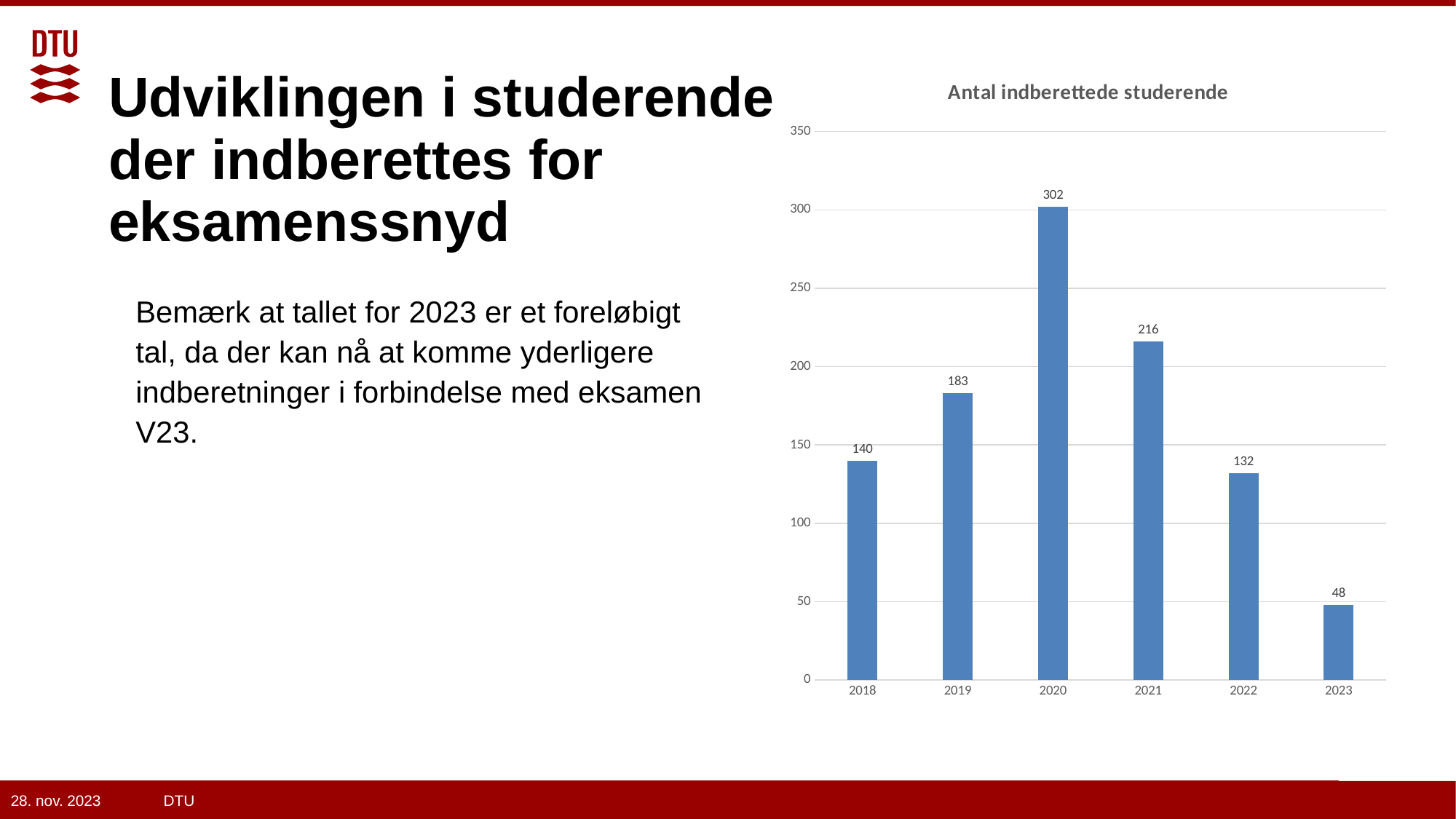
What is the title of the chart? Antal indberettede studerende What kind of chart is shown on the slide? Bar chart Which year has the highest value? 2020 What is the value for 2019? 183 Which is larger, the value for 2019 or the value for 2022? 2019 What is the difference between the values for 2018 and 2022? 8 What is the value for 2020? 302 What is the difference between the values for 2020 and 2021? 86 What is the value for 2023? 48 How many years are shown on the x axis? 6 Is the value for 2021 greater or less than 200? greater Which year has the lowest value? 2023